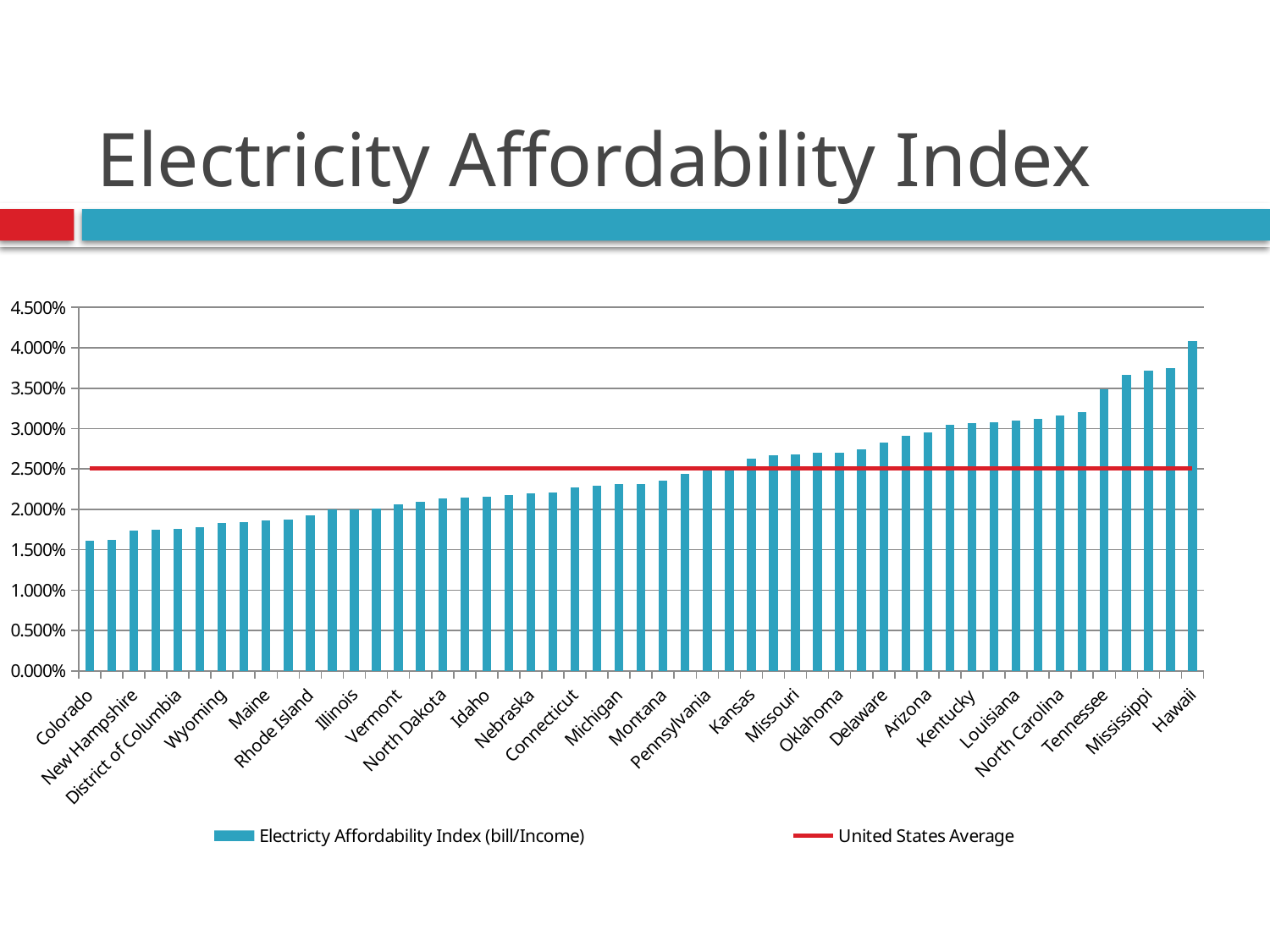
What colour is the United States Average line? red What kind of chart is shown on the slide? bar chart Is the value for Delaware greater or less than 2.500%? greater Which state has the lowest Electricity Affordability Index? Colorado Is the value for Hawaii greater or less than 3.500%? greater Which state has the highest Electricity Affordability Index? Hawaii Is the United States Average line greater or less than 3.000%? less Do the bar values rise or fall moving from left to right along the x axis? rise Which has a larger Electricity Affordability Index, Mississippi or Maine? Mississippi How many series does the legend list? 2